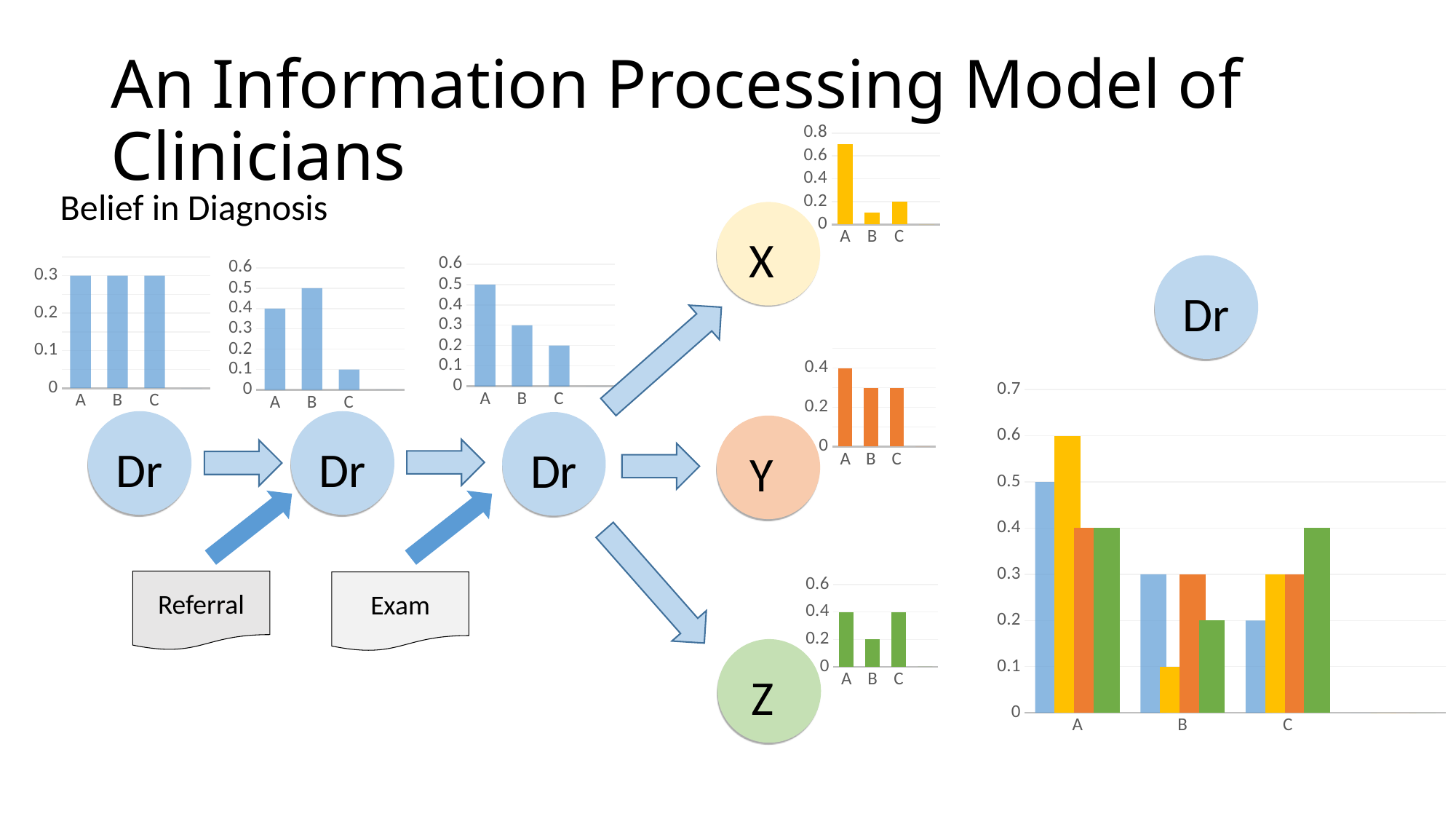
In the yellow chart next to the X circle, is the value for A greater or less than 0.6? greater In the green chart next to the Z circle, which category has the lowest value? B In the large chart on the right, what is the difference between the blue bar for A and the blue bar for C? 0.3 In the large chart on the right, what is the value of the yellow bar for A? 0.6 In the small chart above the second Dr circle, which category has the highest value? B In the small chart above the third Dr circle, what is the value for A? 0.5 In the small chart above the third Dr circle, do the values rise or fall from A to C? fall In the large chart on the right, how many categories are shown on the x axis? 3 In the leftmost small chart above the first Dr circle, what is the value for A? 0.3 In the orange chart next to the Y circle, which category has the highest value? A In the small chart above the second Dr circle, what is the value for C? 0.1 In the green chart next to the Z circle, what is the value for C? 0.4